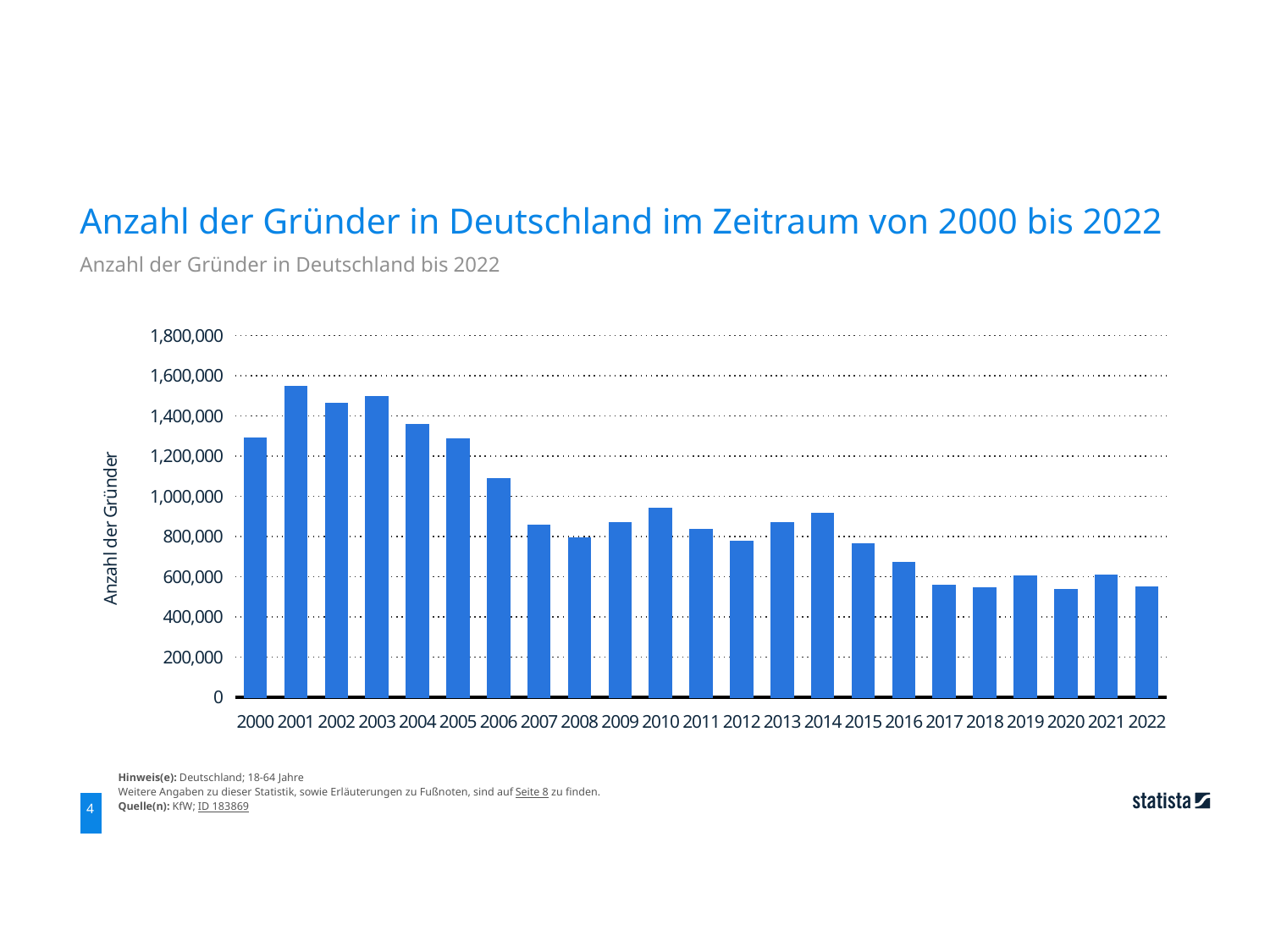
Is the value for 2017 greater or less than 600,000? less Is the value for 2001 greater or less than 1,400,000? greater Which year has the larger value, 2010 or 2011? 2010 What is the label of the y axis? Anzahl der Gründer Is the value for 2006 greater or less than 1,000,000? greater Which year has the highest number of founders (Anzahl der Gründer)? 2001 How many years are shown on the x axis of the chart? 23 Overall, do the values rise or fall from 2000 to 2022? Fall What kind of chart is shown on the slide? Bar chart Which year has the larger value, 2000 or 2006? 2000